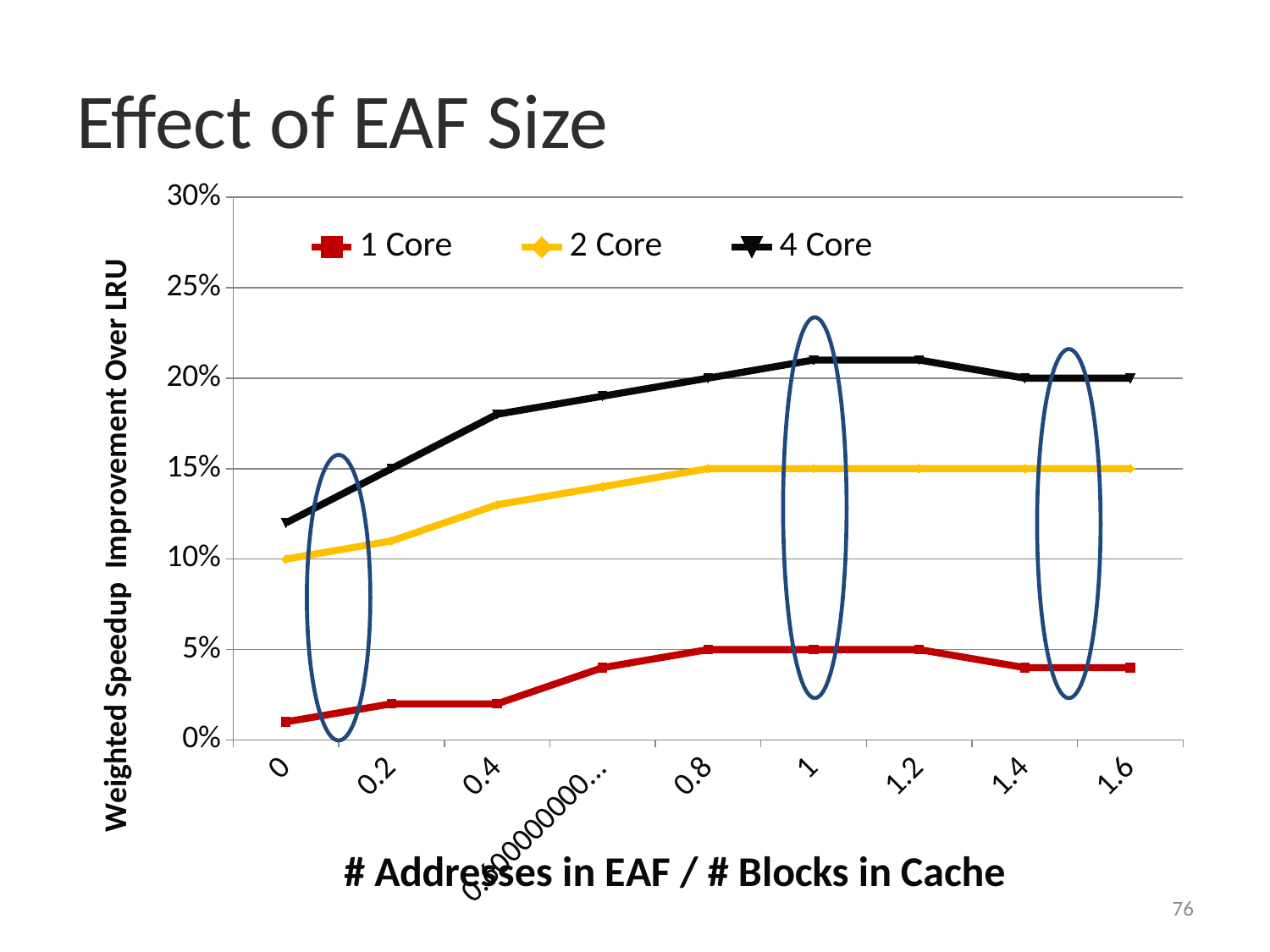
Which series has the lowest weighted speedup improvement across the chart? 1 Core What is the weighted speedup improvement for 4 Core at x = 1.6? 20% What is the weighted speedup improvement for 2 Core at x = 0? 10% Which series has the highest weighted speedup improvement at an x value of 1? 4 Core What is the label of the x axis? # Addresses in EAF / # Blocks in Cache What is the weighted speedup improvement for 1 Core at x = 1? 5% Does the 4 Core series rise or fall from x = 0 to x = 1? rise What kind of chart is shown on the slide? line chart What is the weighted speedup improvement for 2 Core at x = 1.6? 15% Is the value for 1 Core at x = 0.2 greater or less than 5%? less How many series does the legend list? 3 Is the value for 4 Core at x = 0 greater or less than 10%? greater